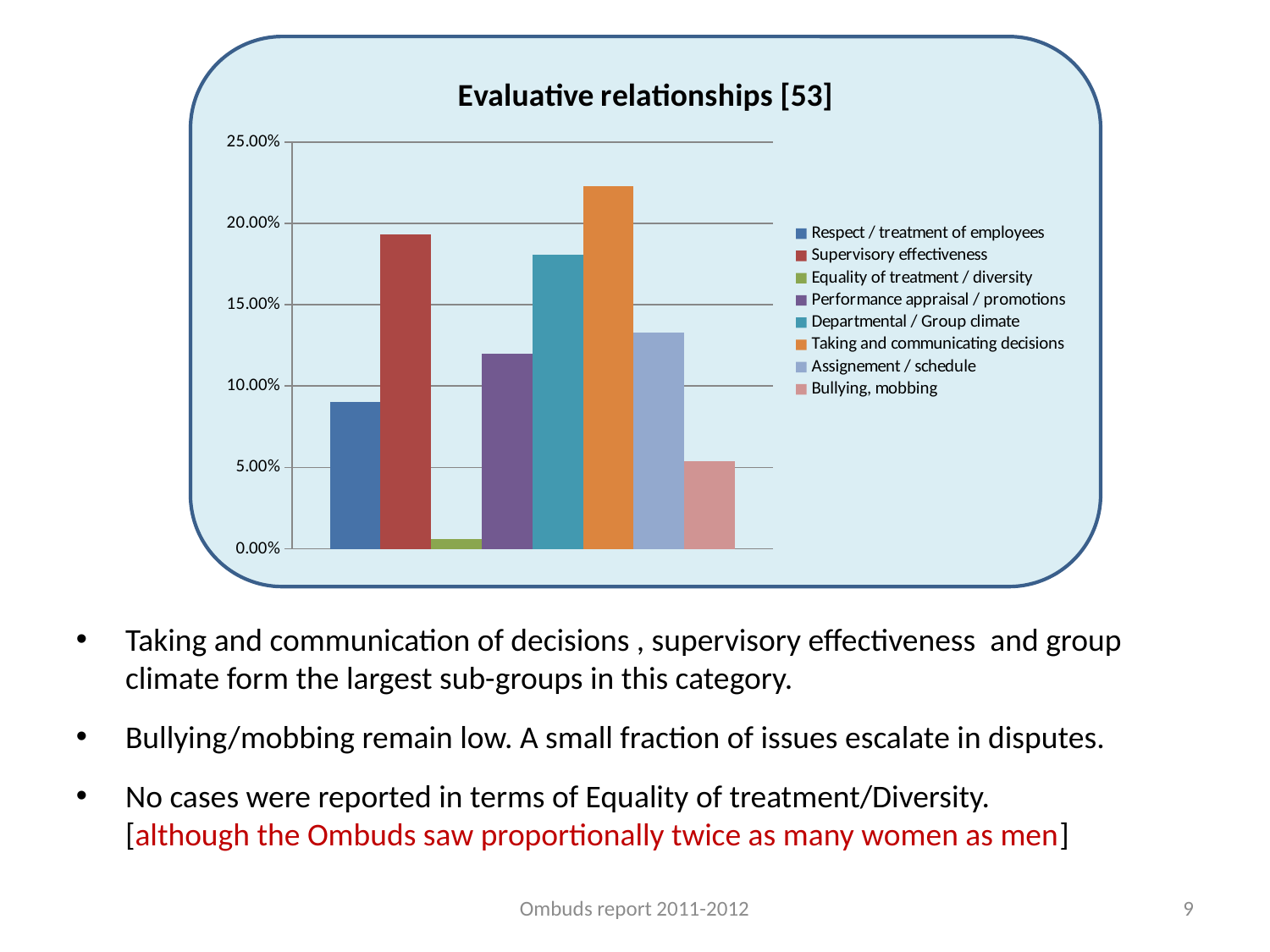
Is the value for Respect / treatment of employees greater or less than 10.00%? less Which series has the highest value? Taking and communicating decisions Which is larger, the value for Assignement / schedule or the value for Respect / treatment of employees? Assignement / schedule What is the title of the chart? Evaluative relationships [53] Is the value for Taking and communicating decisions greater or less than 20.00%? greater How many bars are plotted in the chart? 8 Which series has the lowest value? Equality of treatment / diversity What type of chart is shown on the slide? bar chart Which is larger, the value for Performance appraisal / promotions or the value for Bullying, mobbing? Performance appraisal / promotions Is the value for Bullying, mobbing greater or less than 10.00%? less How many series does the legend list? 8